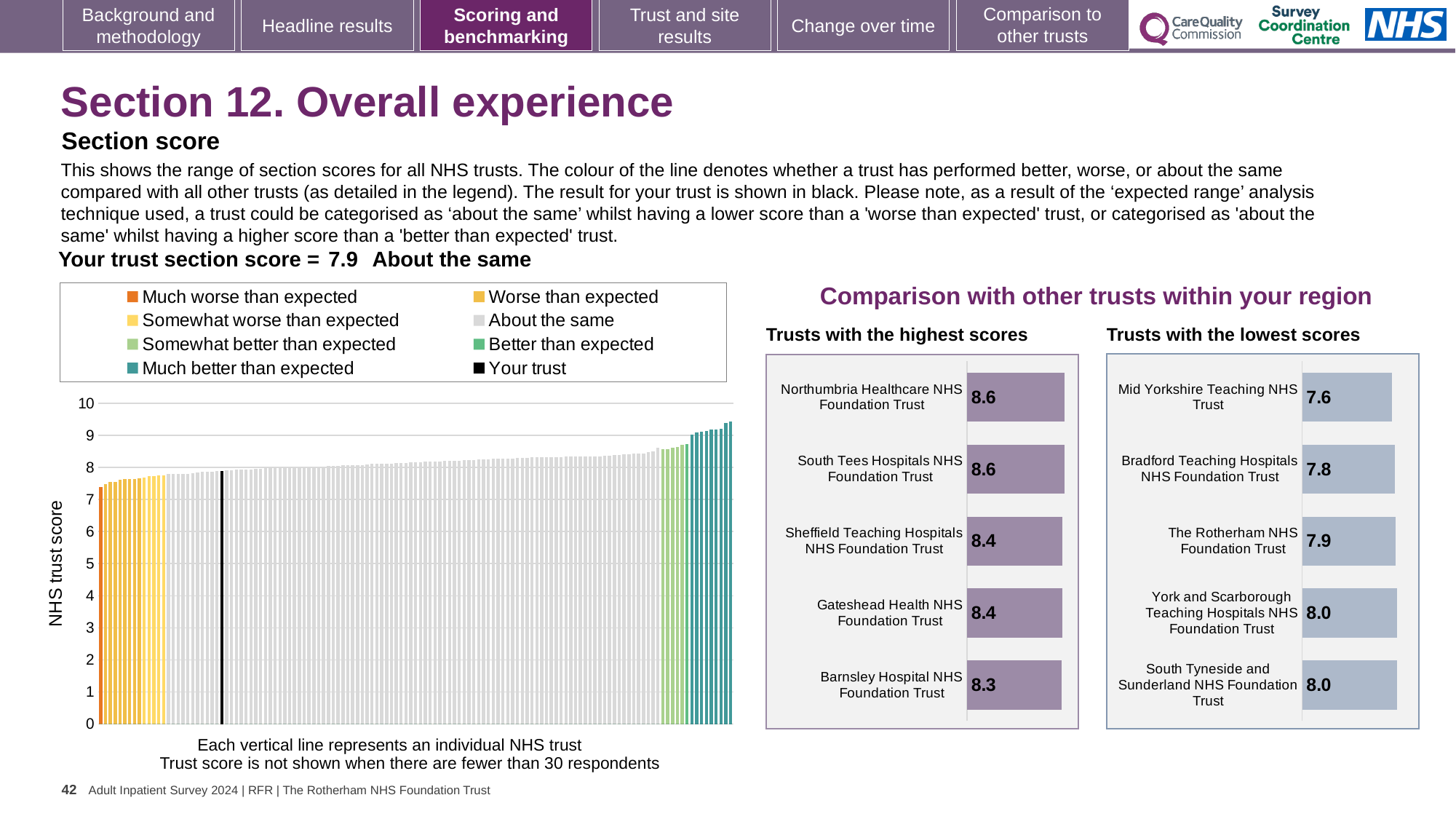
On the large chart on the left, what is the section score for your trust? 7.9 What kind of chart is the large chart on the left of the slide? Bar chart On the 'Trusts with the highest scores' chart, what is the score for Northumbria Healthcare NHS Foundation Trust? 8.6 On the 'Trusts with the highest scores' chart, which has the higher score: Sheffield Teaching Hospitals NHS Foundation Trust or Barnsley Hospital NHS Foundation Trust? Sheffield Teaching Hospitals NHS Foundation Trust On the 'Trusts with the highest scores' chart, what is the score for Barnsley Hospital NHS Foundation Trust? 8.3 On the 'Trusts with the lowest scores' chart, what is the difference between the scores of York and Scarborough Teaching Hospitals NHS Foundation Trust and Mid Yorkshire Teaching NHS Trust? 0.4 On the 'Trusts with the lowest scores' chart, what is the score for Bradford Teaching Hospitals NHS Foundation Trust? 7.8 On the 'Trusts with the highest scores' chart, how many trusts are listed? 5 On the 'Trusts with the lowest scores' chart, which trust has the lowest score? Mid Yorkshire Teaching NHS Trust On the 'Trusts with the lowest scores' chart, what is the difference between the scores of The Rotherham NHS Foundation Trust and Mid Yorkshire Teaching NHS Trust? 0.3 On the large chart on the left, do the trust scores rise or fall from left to right? Rise On the large chart on the left, how many entries does the legend list? 8